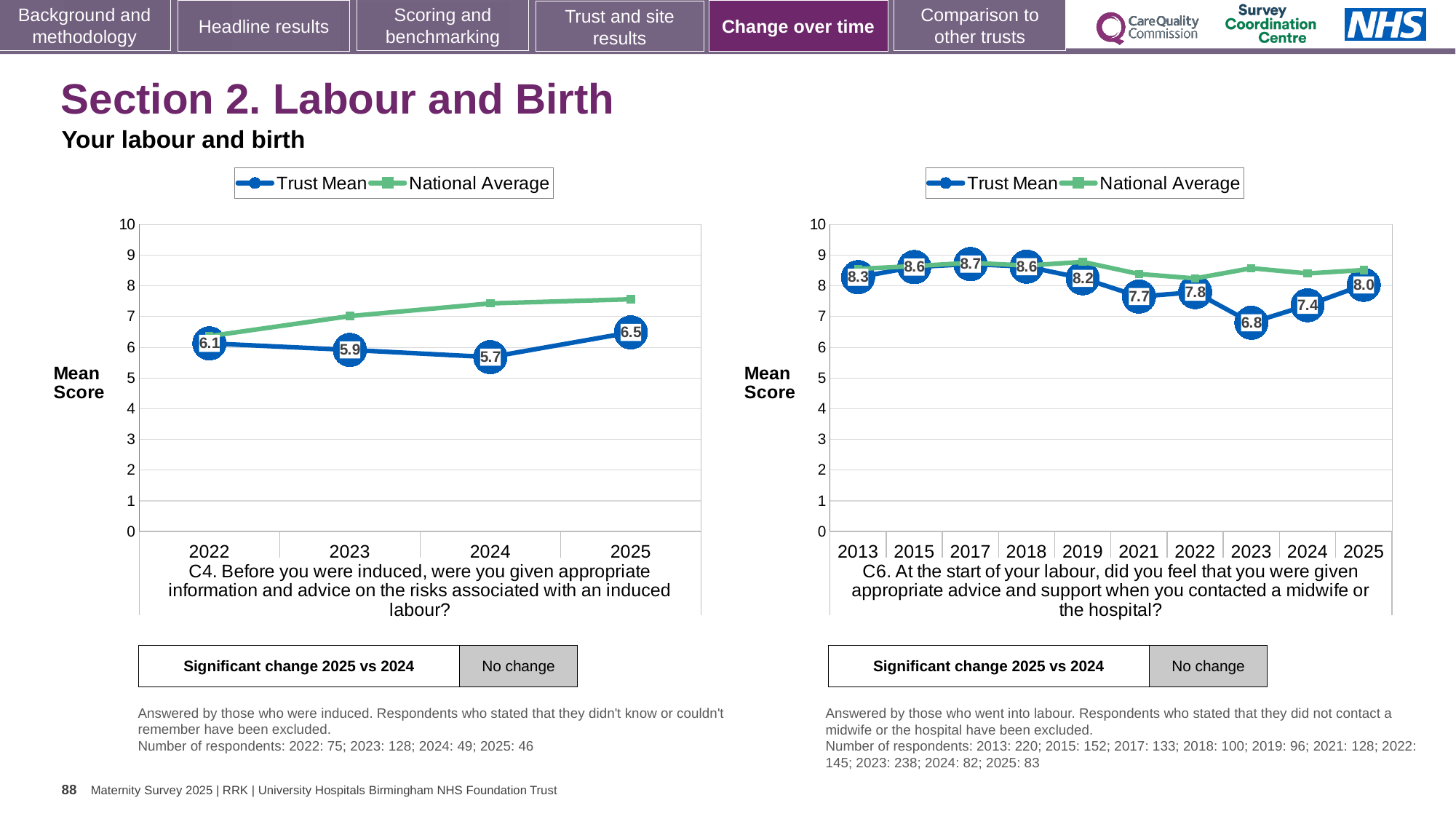
What type of chart is the right chart (C6)? Line chart In the right chart (C6), how many years are plotted on the x axis? 10 In the right chart (C6), is the Trust Mean for 2024 larger than the Trust Mean for 2023? Yes In the right chart (C6), which year has the highest Trust Mean? 2017 In the right chart (C6), what is the Trust Mean for 2023? 6.8 In the right chart (C6), which year has the lowest Trust Mean? 2023 In the left chart (C4), what is the Trust Mean for 2024? 5.7 In the left chart (C4), how many years are plotted on the x axis? 4 In the left chart (C4), is the National Average for 2025 greater or less than 7? greater In the left chart (C4), what is the Trust Mean for 2025? 6.5 In the left chart (C4), which year has the lowest Trust Mean? 2024 In the left chart (C4), what is the difference between the Trust Mean for 2025 and 2024? 0.8